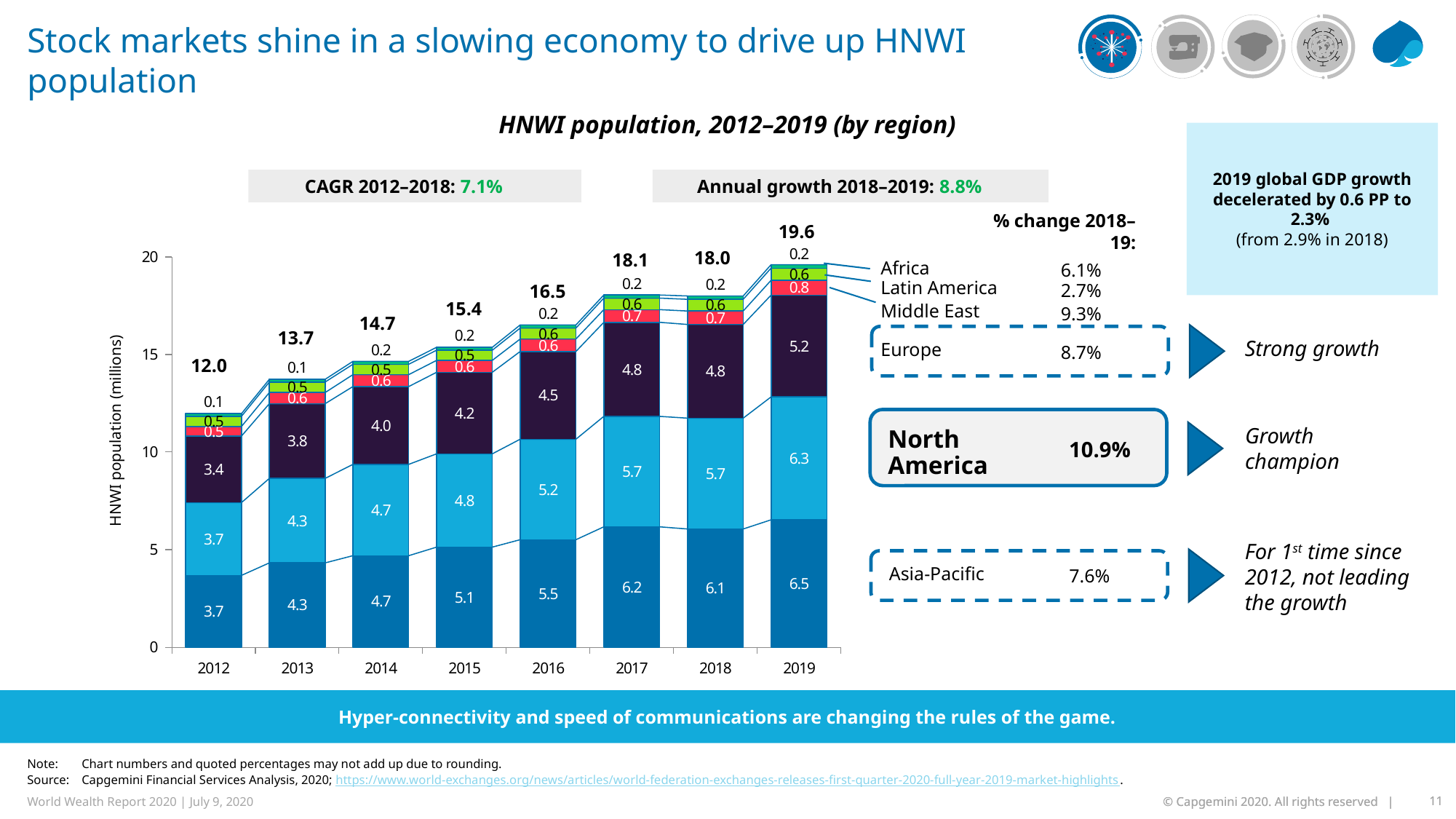
How many years are shown on the x axis of the chart? 8 Which year has the highest total HNWI population? 2019 By how much did the total HNWI population increase from 2018 to 2019? 1.6 What kind of chart is used to show the HNWI population by region? Stacked bar chart Which year has the lowest total HNWI population? 2012 Which year has the larger total HNWI population, 2017 or 2018? 2017 What is the value of the Europe segment in the 2019 bar? 5.2 Does the total HNWI population generally rise or fall from 2012 to 2019? Rise Is the total HNWI population for 2016 greater or less than 15? greater What is the total HNWI population shown for 2019? 19.6 What is the total HNWI population shown for 2012? 12.0 What is the value of the Middle East segment in the 2019 bar? 0.8